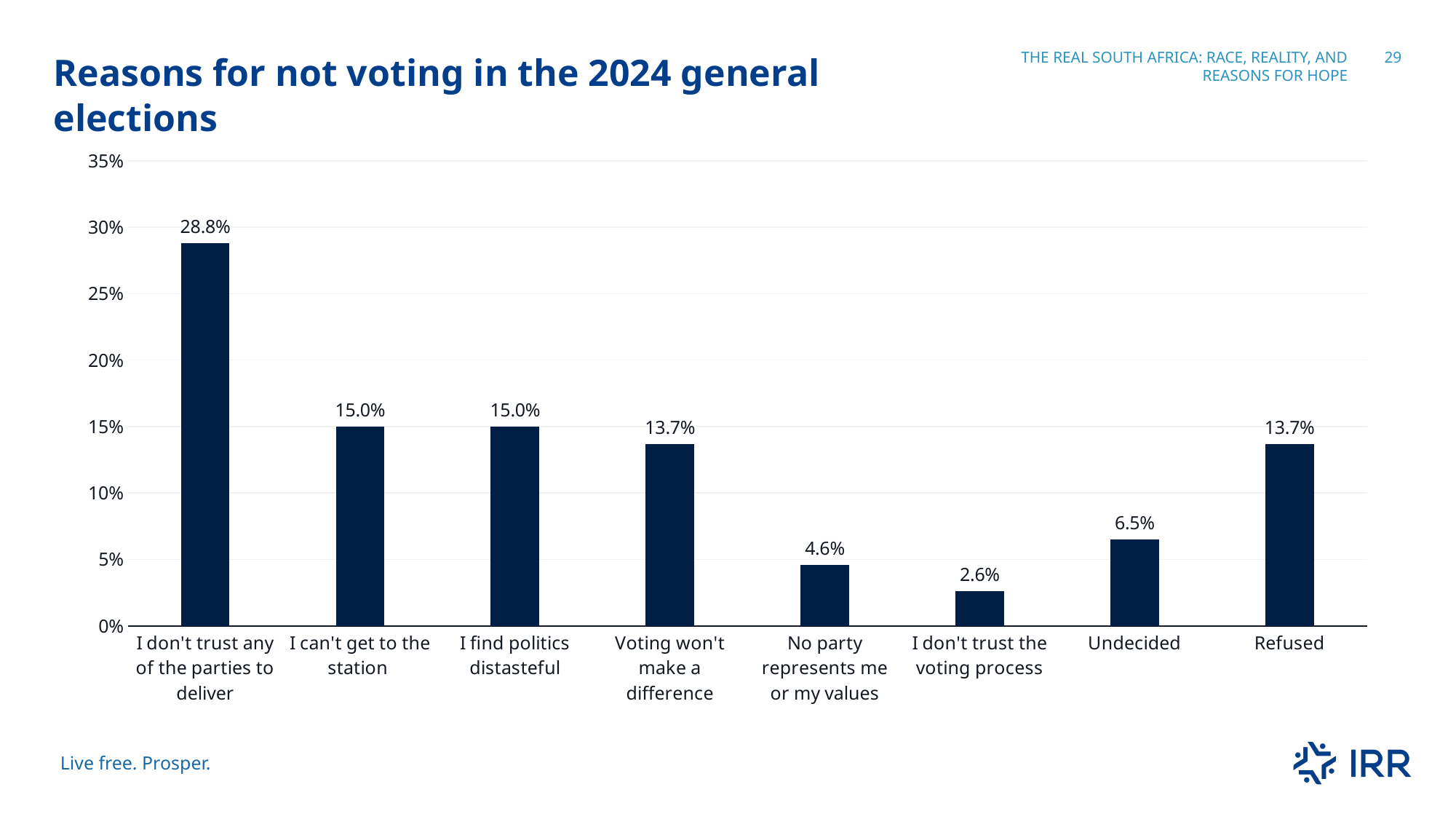
What is the difference between "I don't trust any of the parties to deliver" and "I can't get to the station"? 13.8% How many reasons (categories) are shown on the chart? 8 What is the value for "Undecided"? 6.5% Is the value for "Refused" greater or less than 10%? greater What is the value for "No party represents me or my values"? 4.6% Which reason has the highest percentage? I don't trust any of the parties to deliver Which reason has the lowest percentage? I don't trust the voting process What is the difference between "Undecided" and "I don't trust the voting process"? 3.9% What kind of chart is shown on the slide? Bar chart Which is larger: the value for "Voting won't make a difference" or the value for "Undecided"? Voting won't make a difference What percentage of respondents gave "I don't trust any of the parties to deliver" as their reason for not voting? 28.8% What is the title of the chart? Reasons for not voting in the 2024 general elections